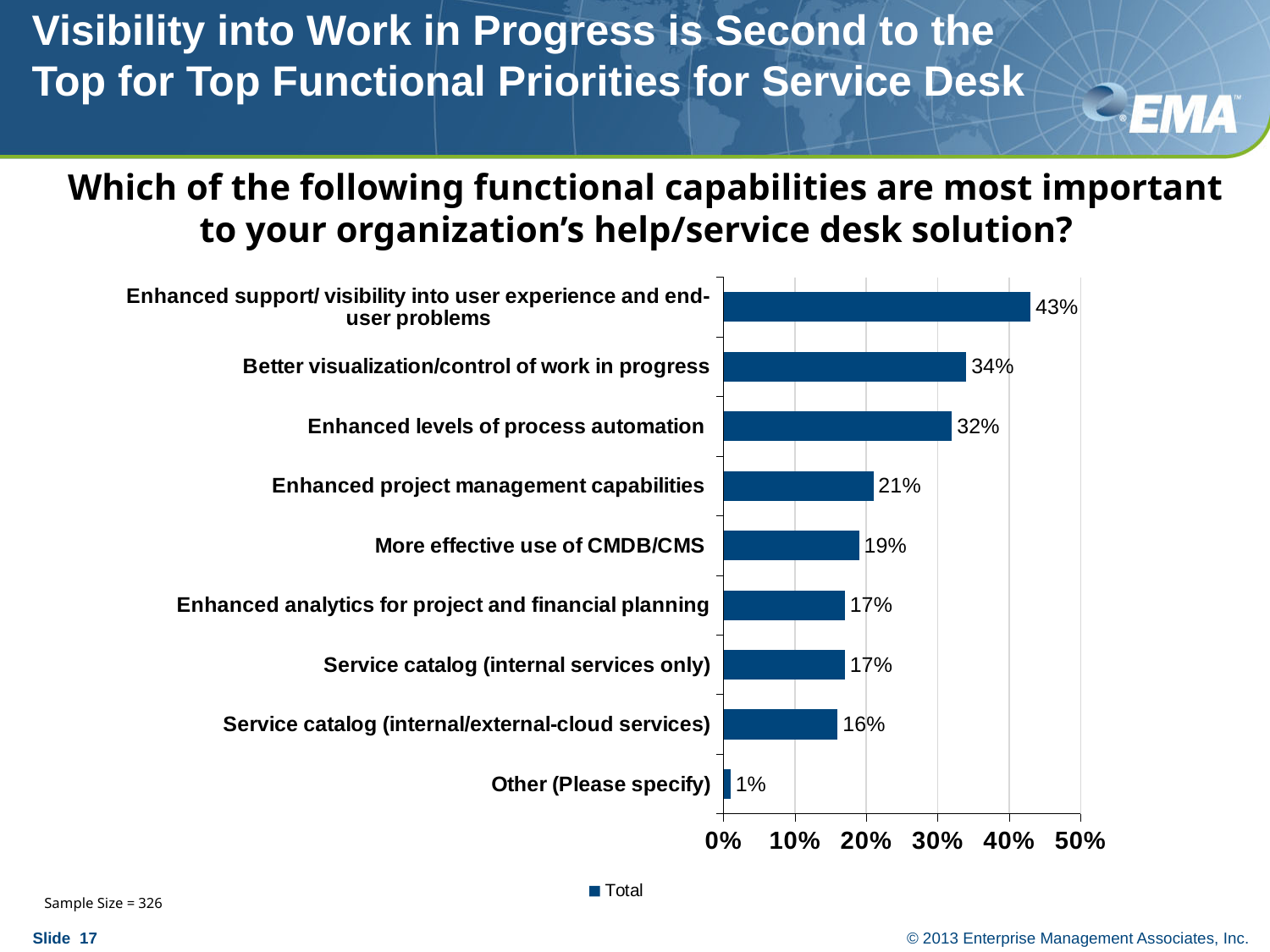
Which category has the lowest value? Other (Please specify) Which category has the highest value? Enhanced support/ visibility into user experience and end-user problems What is the value for "More effective use of CMDB/CMS"? 19% What percentage is shown for "Service catalog (internal/external-cloud services)"? 16% What is the difference between "Enhanced support/ visibility into user experience and end-user problems" and "Better visualization/control of work in progress"? 9% What type of chart is shown on the slide? bar chart Which is larger: "Enhanced levels of process automation" or "Enhanced project management capabilities"? Enhanced levels of process automation How many categories are shown in the chart? 9 What is the difference between "Enhanced levels of process automation" and "Enhanced project management capabilities"? 11% What percentage is shown for "Better visualization/control of work in progress"? 34% Is the value for "Enhanced support/ visibility into user experience and end-user problems" greater or less than 40%? greater What series name is shown in the chart legend? Total